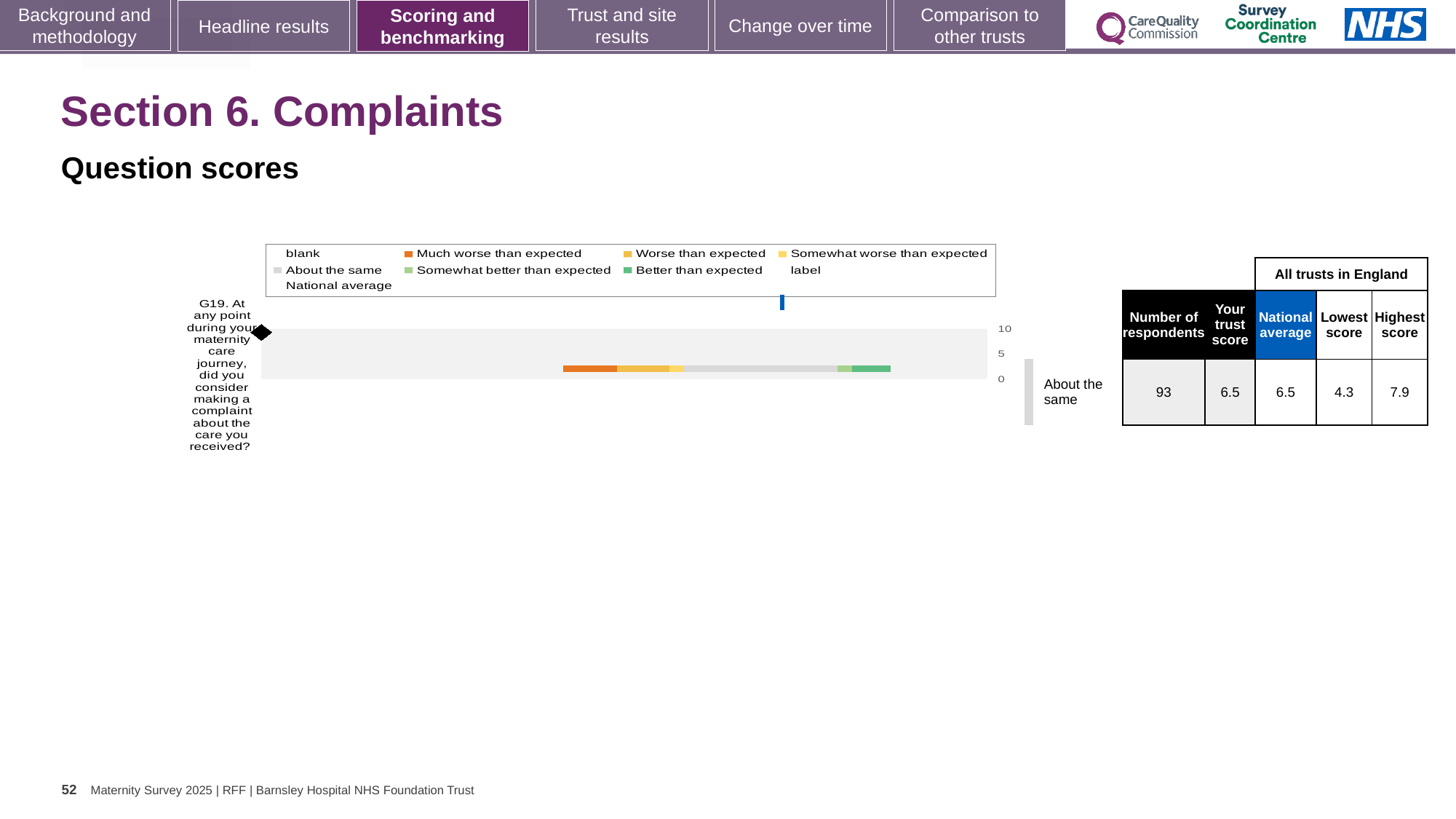
What is the national average score for question G19? 6.5 What is the lowest score among all trusts in England for question G19? 4.3 What is the difference between the highest and lowest trust scores for question G19? 3.6 What is the highest score among all trusts in England for question G19? 7.9 What kind of chart is used to show the question score? Bar chart What is the maximum value shown on the chart's score axis? 10 Is the trust's score for question G19 higher or lower than the national average? The same Which legend entry is shown in orange? Much worse than expected Which benchmarking category is the trust's score for question G19 placed in? About the same How many respondents answered question G19? 93 What is the trust's score for question G19 about considering making a complaint? 6.5 How many questions are plotted on the chart? 1